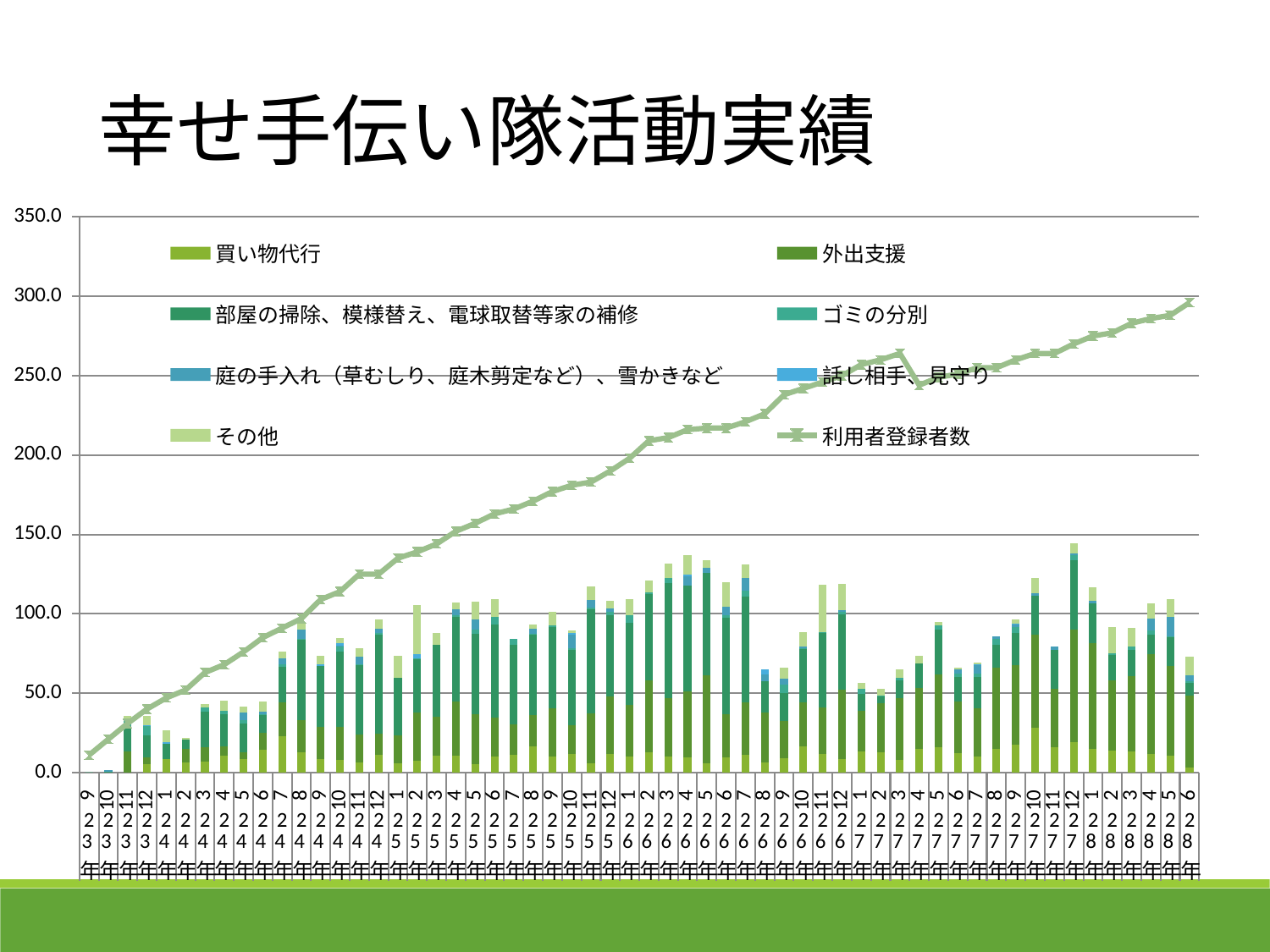
Is the value of the 利用者登録者数 line at 4月 27年 greater or less than 250? less What is the title of the chart on the slide? 幸せ手伝い隊活動実績 Is the total height of the stacked bar for 2月 24年 greater or less than 50? less Which legend entry is plotted as a line rather than as bars? 利用者登録者数 Is the total height of the stacked bar for 12月 27年 greater or less than 100? greater Does the 利用者登録者数 line generally rise or fall from 9月 23年 to 6月 28年? rise What kind of chart is shown on the slide? Stacked bar chart with a line How many series does the legend list? 8